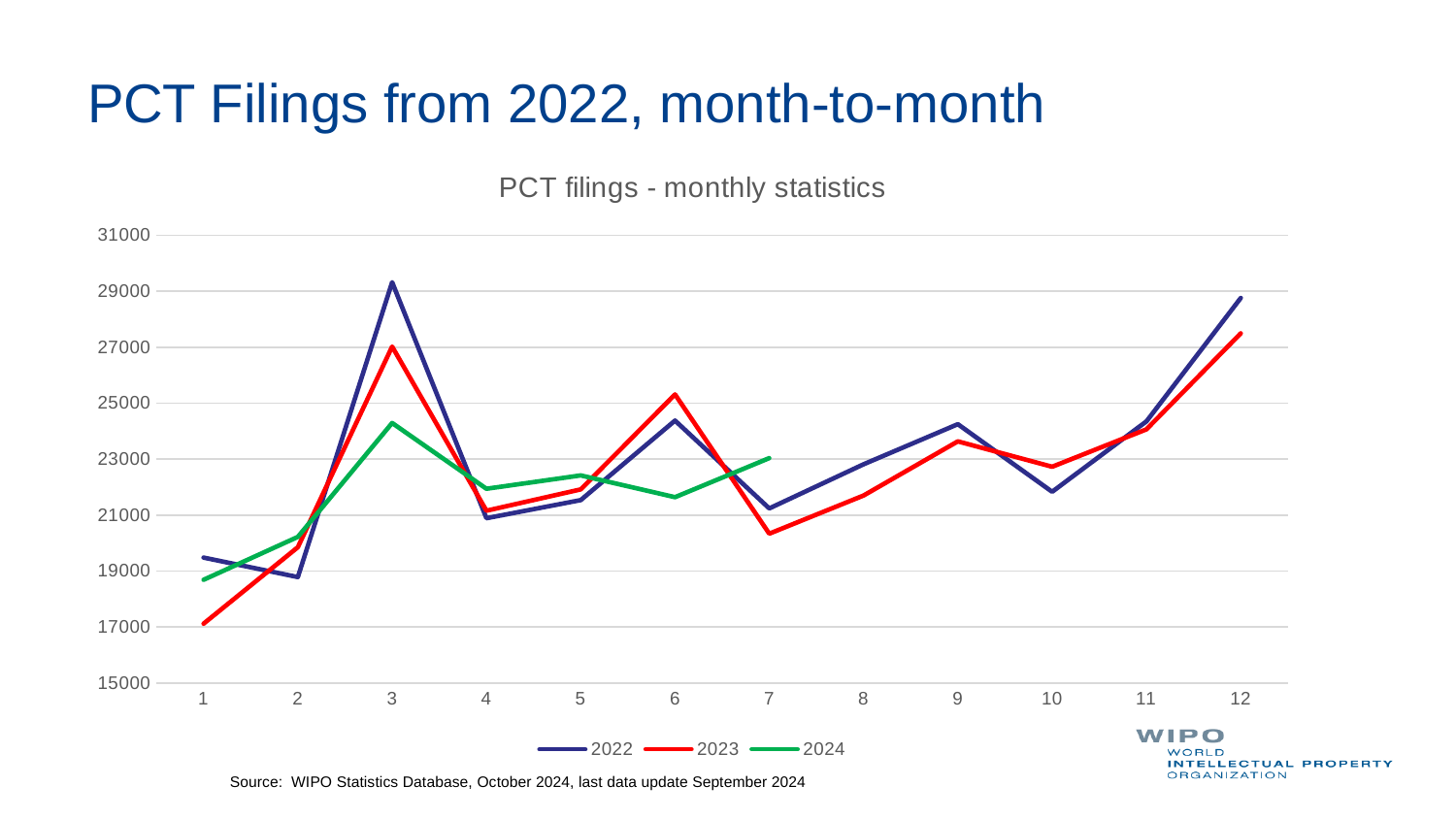
How many months are shown on the x axis? 12 Which month has the lowest value for the 2023 series? 1 Is the value for 2023 in month 1 greater or less than 19000? less What kind of chart is shown on the slide? line chart Is the value for 2022 in month 3 greater or less than 27000? greater Is the value for 2024 in month 3 greater or less than 23000? greater In month 6, which series has the larger value, 2022 or 2023? 2023 Do the values for the 2022 series rise or fall from month 10 to month 12? rise How many series does the legend list? 3 Which month has the highest value for the 2024 series? 3 Which month has the highest value for the 2022 series? 3 What is the title shown above the chart? PCT filings - monthly statistics